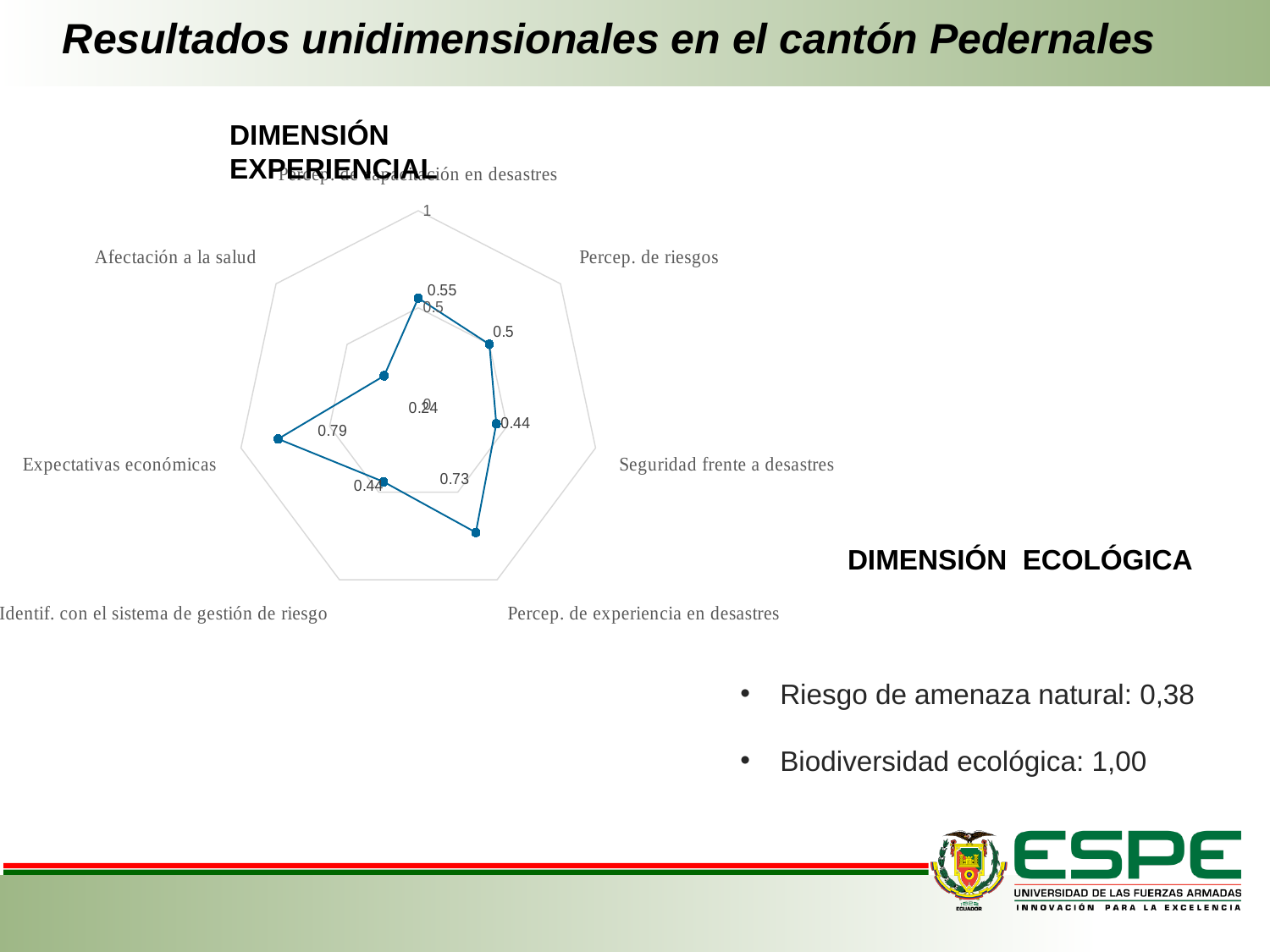
Which category has the highest value in the radar chart? Expectativas económicas Which category has the lowest value in the radar chart? Afectación a la salud What is the value for Afectación a la salud in the radar chart? 0.24 What type of chart is shown under the heading DIMENSIÓN EXPERIENCIAL? Radar chart What is the value for Percep. de experiencia en desastres in the radar chart? 0.73 What is the value for Percep. de capacitación en desastres in the radar chart? 0.55 In the radar chart, which is larger: Percep. de experiencia en desastres or Percep. de riesgos? Percep. de experiencia en desastres What is the value for Expectativas económicas in the radar chart? 0.79 What is the value for Seguridad frente a desastres in the radar chart? 0.44 What is the title of the radar chart? DIMENSIÓN EXPERIENCIAL How many categories (axes) does the radar chart have? 7 What is the difference between the values for Expectativas económicas and Afectación a la salud in the radar chart? 0.55